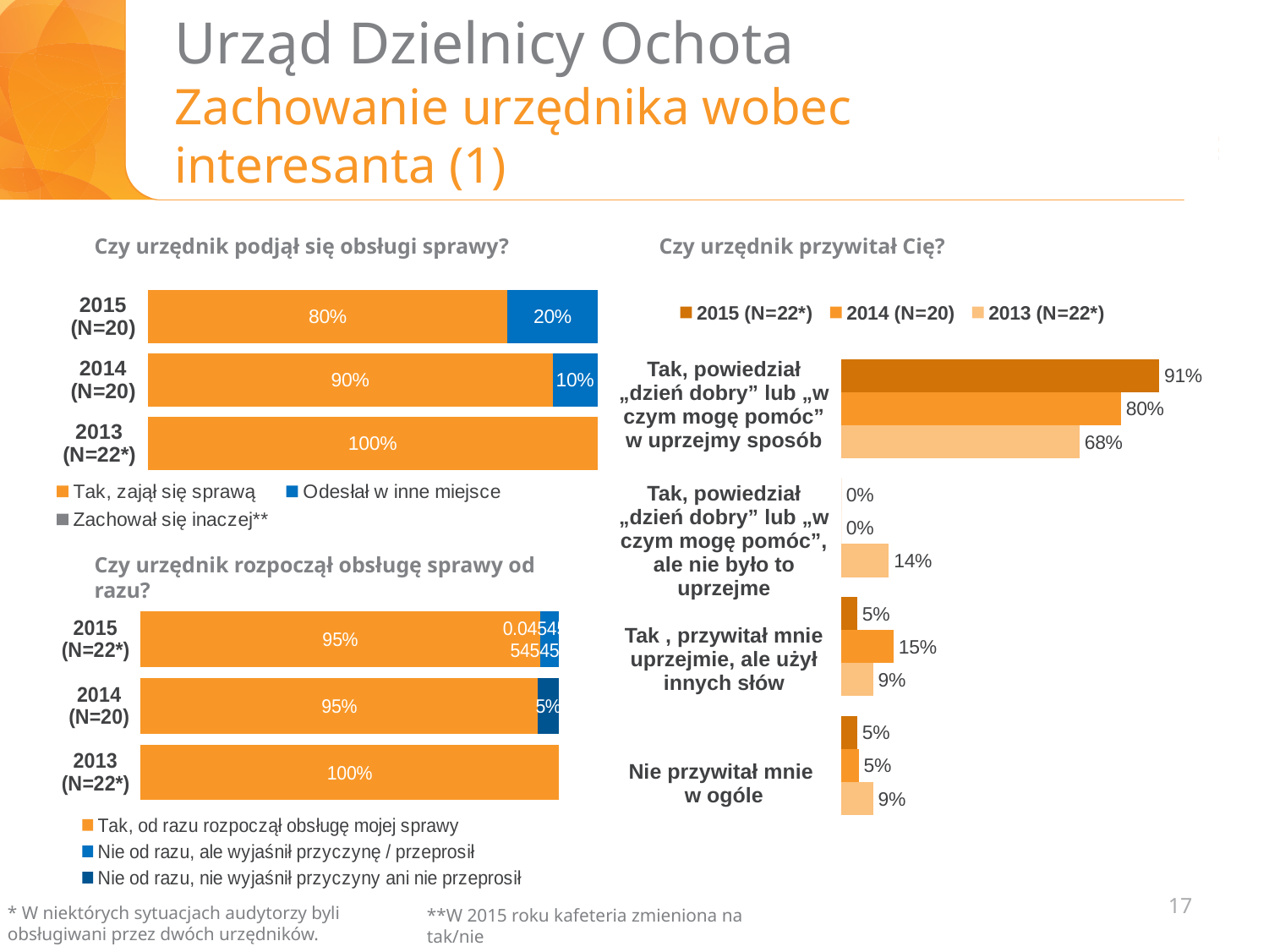
In the chart "Czy urzędnik podjął się obsługi sprawy?", what is the value for "Odesłał w inne miejsce" in 2014 (N=20)? 10% What kind of chart is "Czy urzędnik przywitał Cię?"? Bar chart In the chart "Czy urzędnik podjął się obsługi sprawy?", how many series does the legend list? 3 In the chart "Czy urzędnik przywitał Cię?", what is the value for 2013 (N=22*) in the category "Tak, powiedział „dzień dobry” lub „w czym mogę pomóc”, ale nie było to uprzejme"? 14% In the chart "Czy urzędnik rozpoczął obsługę sprawy od razu?", how many year categories are shown? 3 In the chart "Czy urzędnik przywitał Cię?", which year has the highest value for "Tak , przywitał mnie uprzejmie, ale użył innych słów"? 2014 (N=20) In the chart "Czy urzędnik przywitał Cię?", what is the value for 2015 (N=22*) in the category "Tak, powiedział „dzień dobry” lub „w czym mogę pomóc” w uprzejmy sposób"? 91% In the chart "Czy urzędnik rozpoczął obsługę sprawy od razu?", what is the value for "Tak, od razu rozpoczął obsługę mojej sprawy" in 2014 (N=20)? 95% In the chart "Czy urzędnik podjął się obsługi sprawy?", which year has the highest value for "Tak, zajął się sprawą"? 2013 (N=22*) In the chart "Czy urzędnik rozpoczął obsługę sprawy od razu?", what is the value for "Tak, od razu rozpoczął obsługę mojej sprawy" in 2013 (N=22*)? 100% In the chart "Czy urzędnik podjął się obsługi sprawy?", what is the value for "Tak, zajął się sprawą" in 2015 (N=20)? 80% In the chart "Czy urzędnik przywitał Cię?", what is the difference between the 2015 (N=22*) and 2013 (N=22*) values for "Tak, powiedział „dzień dobry” lub „w czym mogę pomóc” w uprzejmy sposób"? 23%